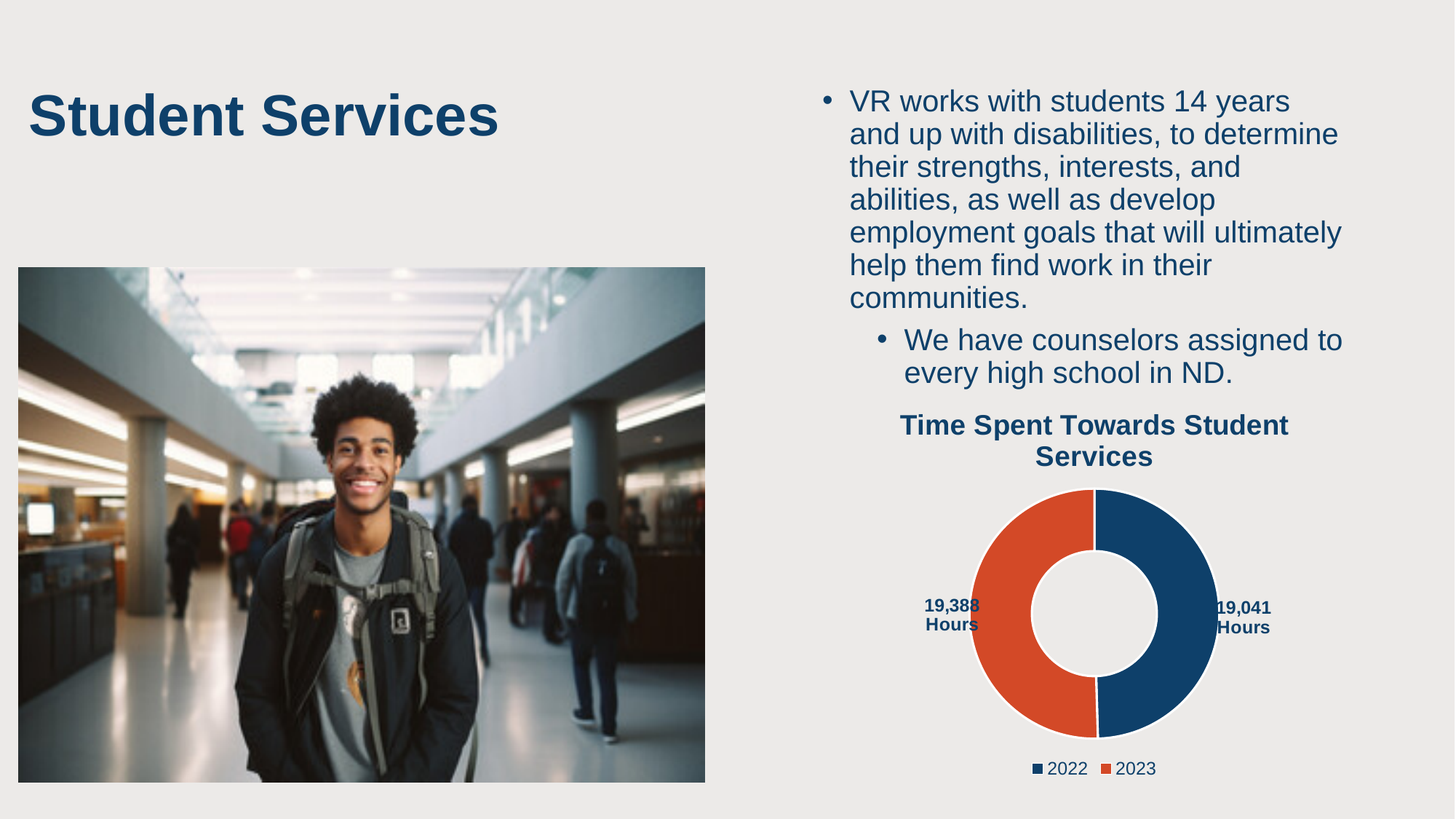
What is the combined total of hours shown for 2022 and 2023? 38,429 Hours How many slices does the doughnut chart have? 2 How many series does the chart legend list? 2 What is the title of the chart on the slide? Time Spent Towards Student Services Which year shows the higher number of hours spent towards student services? 2023 Which years are listed in the chart legend? 2022 and 2023 Is the value for 2023 larger or smaller than the value for 2022? Larger What type of chart is shown under the title "Time Spent Towards Student Services"? Doughnut chart How many hours were spent towards student services in 2022? 19,041 Hours How many hours were spent towards student services in 2023? 19,388 Hours What is the difference in hours between 2023 and 2022? 347 Hours Which year shows the lower number of hours spent towards student services? 2022